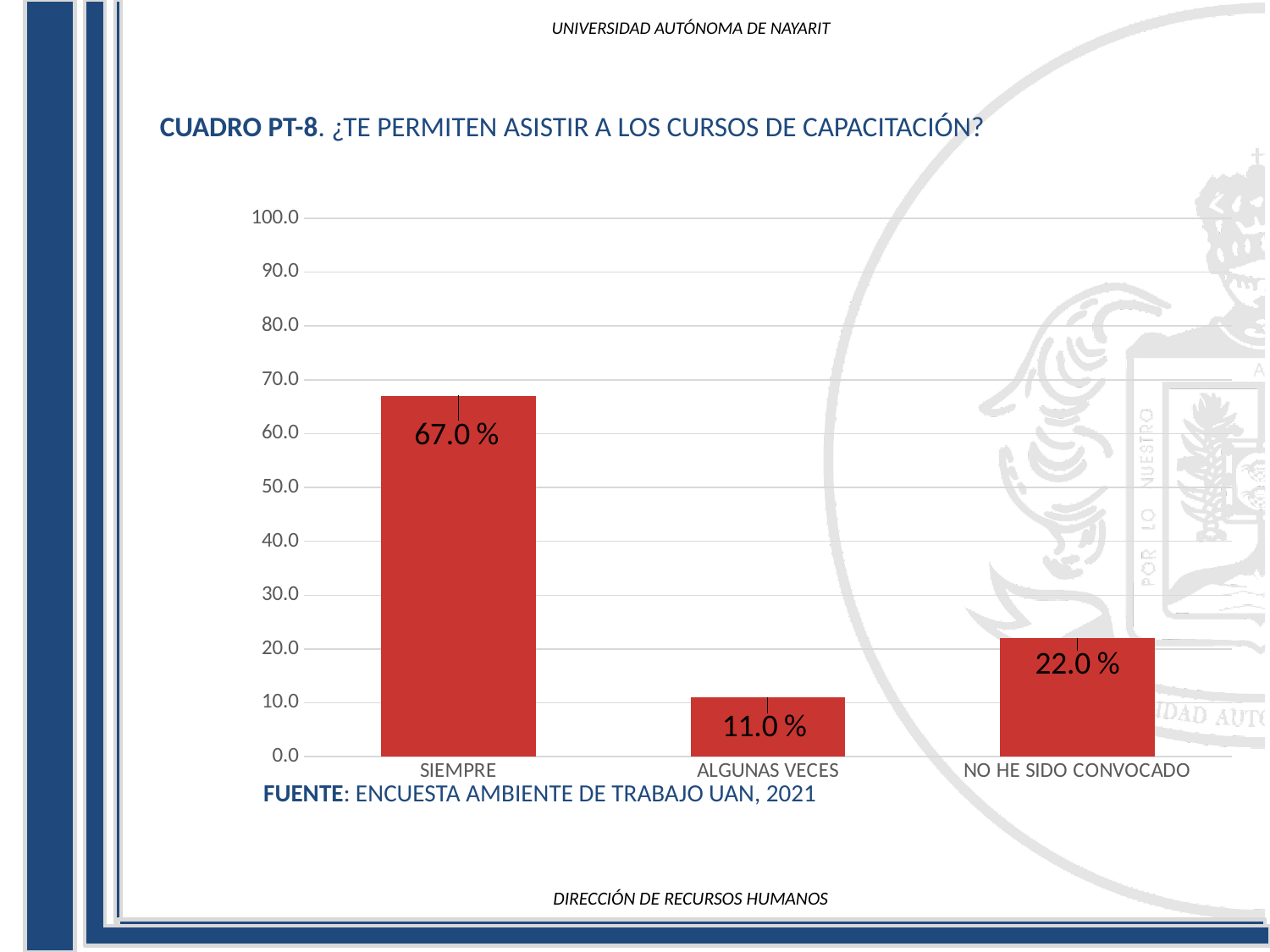
What is the difference between the values for NO HE SIDO CONVOCADO and ALGUNAS VECES? 11.0 % How many categories are shown in the chart? 3 Is the value for SIEMPRE greater or less than 60.0? greater Which category has the highest value? SIEMPRE What is the value for NO HE SIDO CONVOCADO? 22.0 % Which category has the lowest value? ALGUNAS VECES Which is larger, the value for ALGUNAS VECES or the value for NO HE SIDO CONVOCADO? NO HE SIDO CONVOCADO What kind of chart is shown on the slide? bar chart What is the value for SIEMPRE? 67.0 % What is the value for ALGUNAS VECES? 11.0 % What is the source cited below the chart? ENCUESTA AMBIENTE DE TRABAJO UAN, 2021 What is the difference between the values for SIEMPRE and NO HE SIDO CONVOCADO? 45.0 %